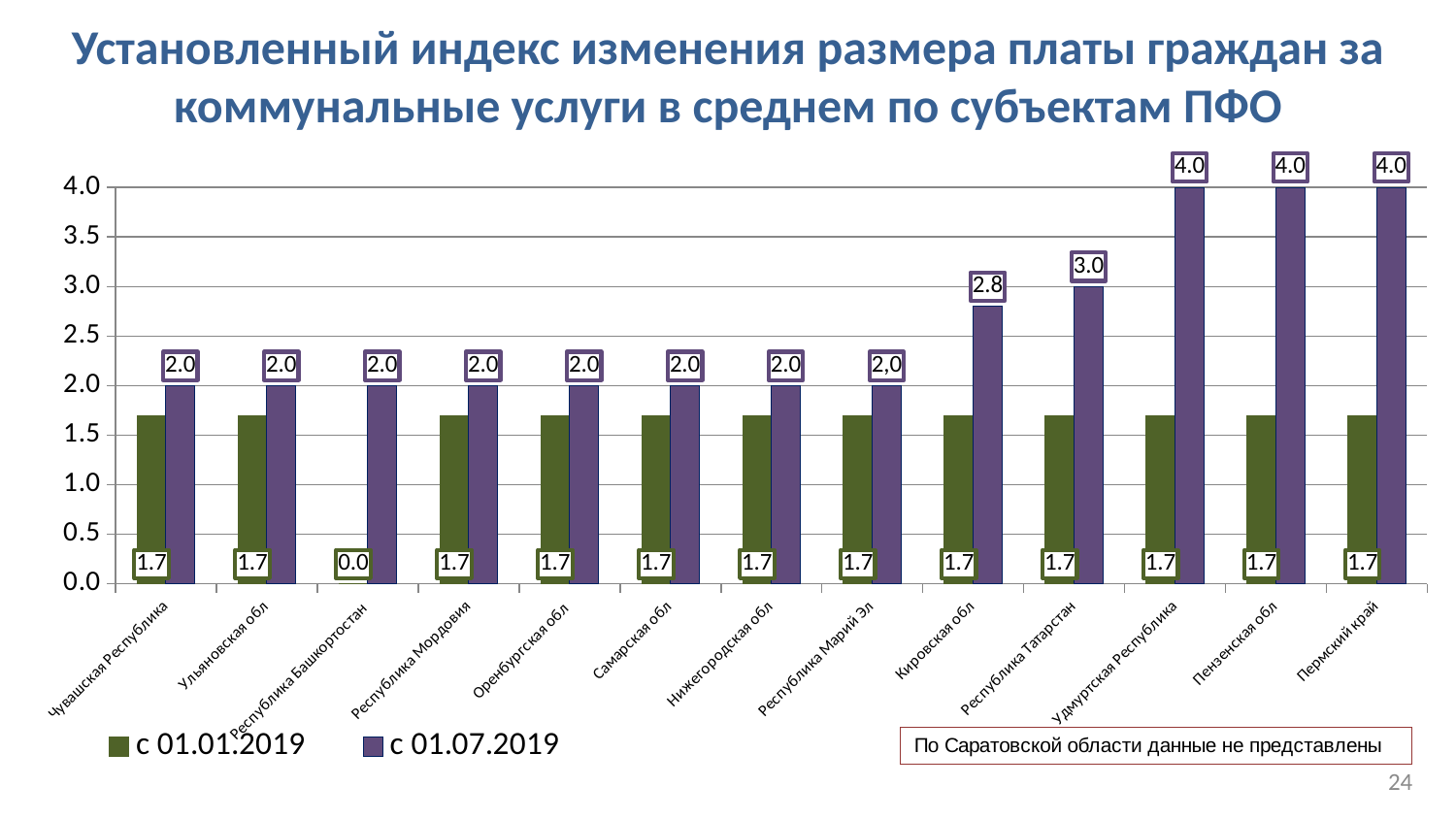
What does the note box at the bottom right of the slide say? По Саратовской области данные не представлены Which is larger for Удмуртская Республика: the 'с 01.01.2019' value or the 'с 01.07.2019' value? с 01.07.2019 What is the value for Самарская обл in the series 'с 01.07.2019'? 2.0 What is the value for Кировская обл in the series 'с 01.07.2019'? 2.8 What is the value for Республика Татарстан in the series 'с 01.07.2019'? 3.0 What is the value for Республика Башкортостан in the series 'с 01.01.2019'? 0.0 How many regions (categories) are plotted on the x axis? 13 What is the difference between the 'с 01.07.2019' and 'с 01.01.2019' values for Республика Татарстан? 1.3 Which region has the lowest value in the series 'с 01.01.2019'? Республика Башкортостан What type of chart is shown on the slide? bar chart What is the difference between the 'с 01.07.2019' values for Пермский край and Кировская обл? 1.2 How many series does the legend list? 2